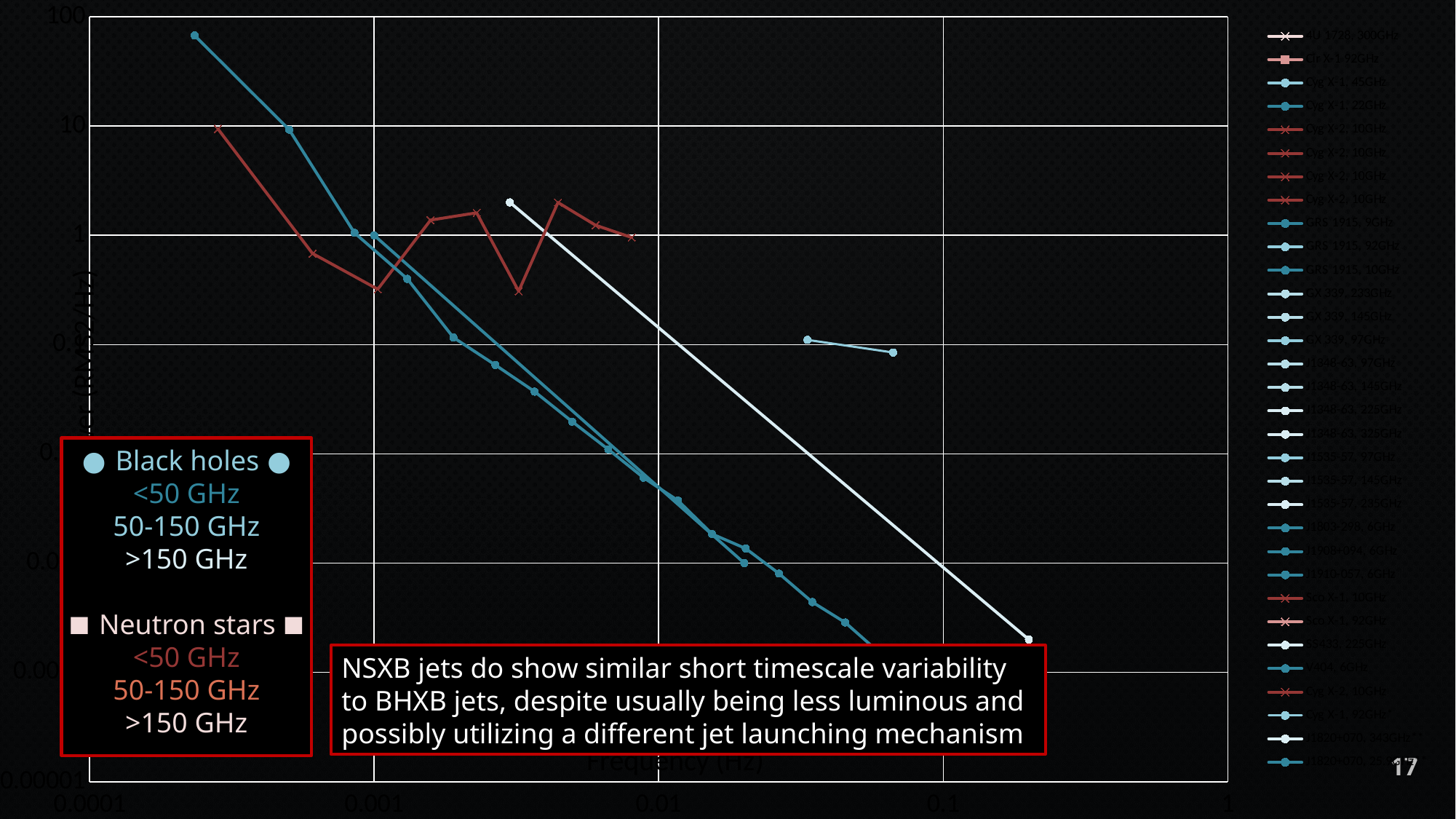
At the far left of the chart, which starts higher: the teal line or the red line? the teal line Which line reaches the highest value on the chart, the teal line or the red line? the teal line Is the value of the rightmost point of the light-blue line (near 0.2 Hz) greater or less than 0.001? less Overall, do the plotted values rise or fall as frequency increases along the x axis? fall Is the lowest point of the red line greater or less than 1? less What kind of chart is shown on the slide? line chart Is the highest point of the red line greater or less than 1? greater What is the label of the x axis? Frequency (Hz) According to the legend box, which class of object is plotted in blue? Black holes